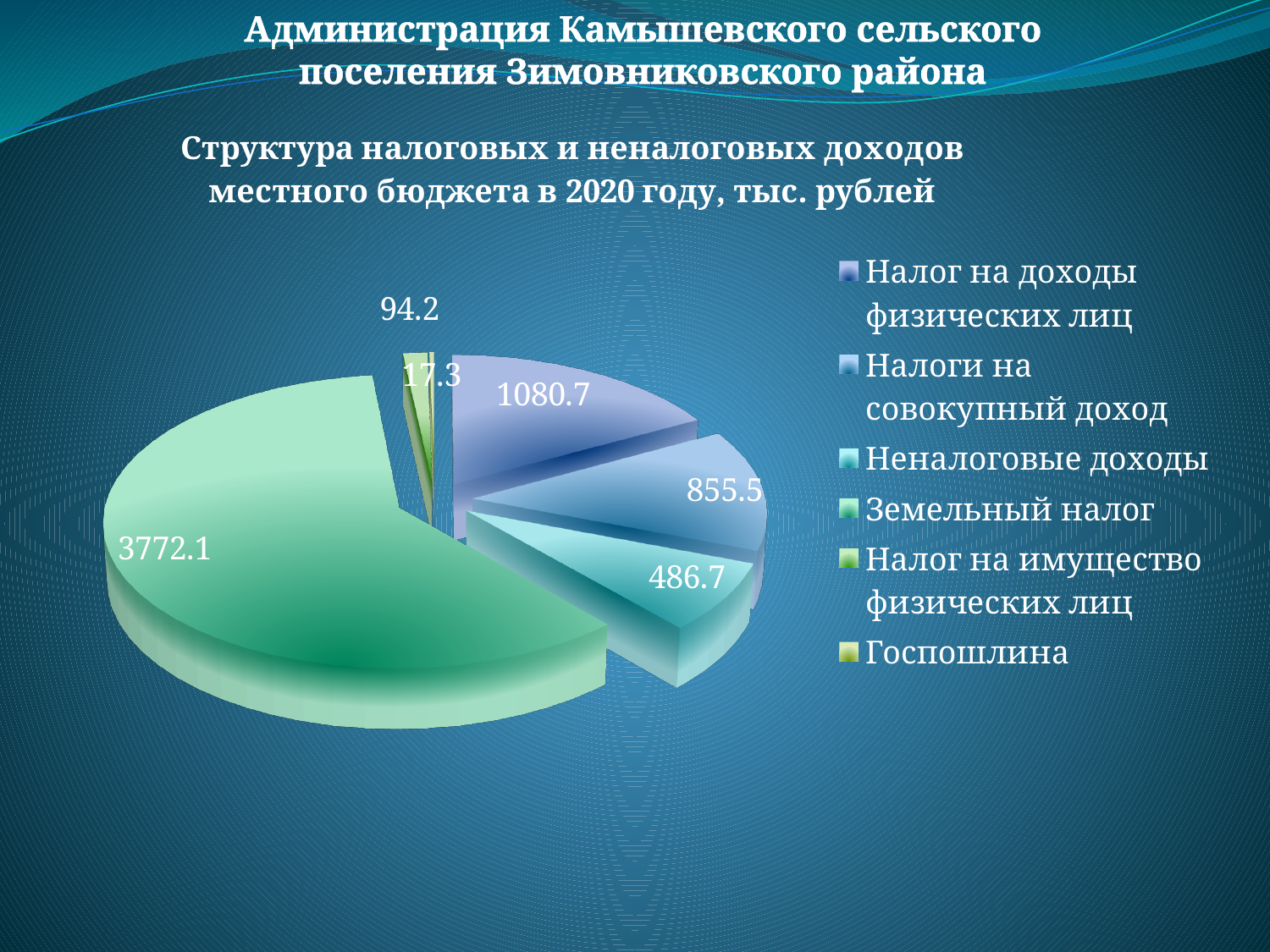
Which category has the smallest slice of the pie? Госпошлина How many categories does the pie chart have? 6 Which is larger: Налоги на совокупный доход or Неналоговые доходы? Налоги на совокупный доход Which category has the largest slice of the pie? Земельный налог What is the value for Госпошлина? 17.3 What kind of chart is shown on the slide? Pie chart What is the value for Земельный налог? 3772.1 What is the value for Неналоговые доходы? 486.7 What year does the chart title say the budget revenue structure refers to? 2020 What is the value for Налог на доходы физических лиц? 1080.7 What is the difference between Налог на имущество физических лиц and Госпошлина? 76.9 What is the difference between Налог на доходы физических лиц and Налоги на совокупный доход? 225.2